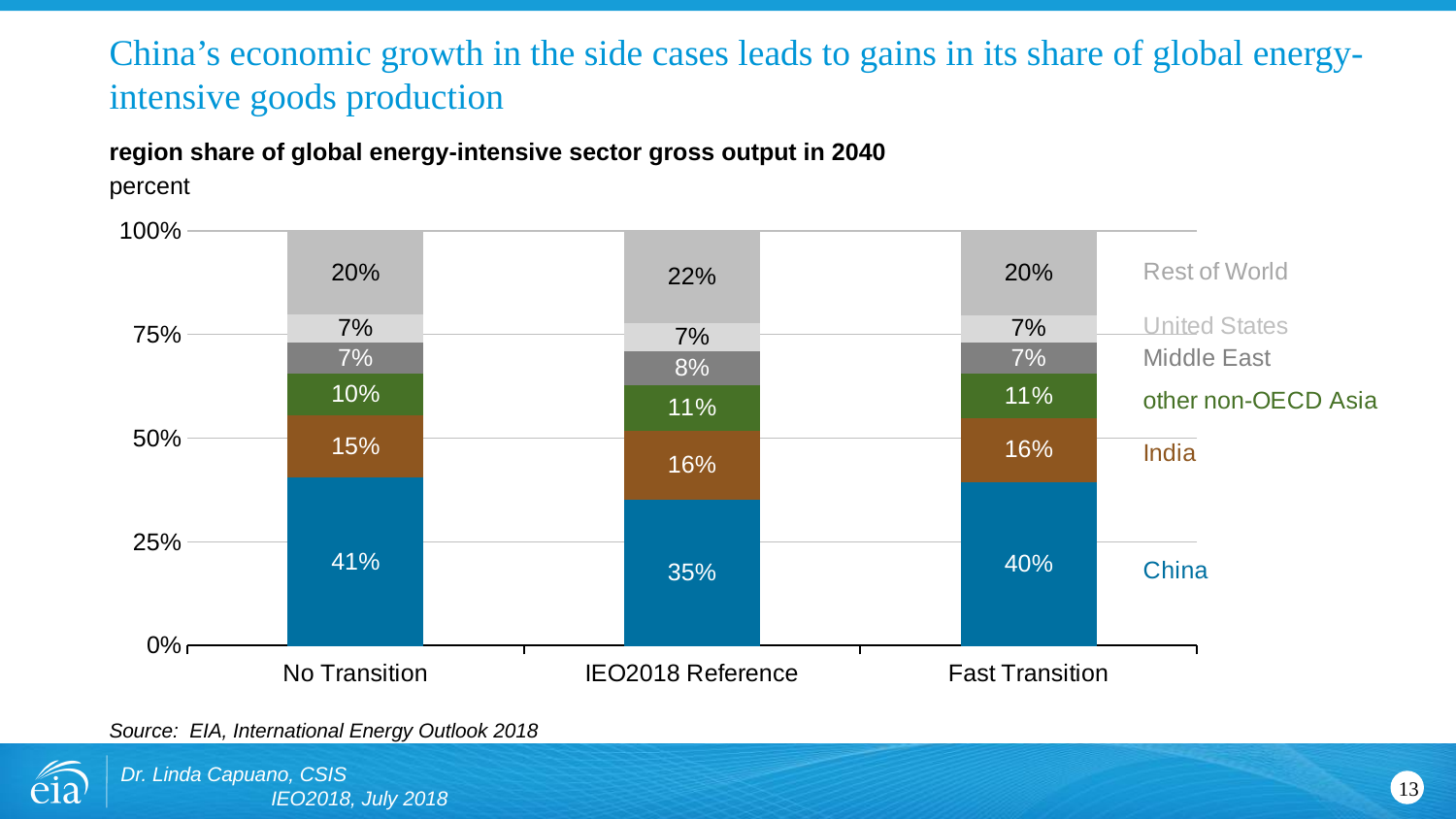
What kind of chart is shown on the slide? Stacked bar chart What is the Middle East share in the Fast Transition case? 7% What is the share for other non-OECD Asia in the No Transition case? 10% In which case is China's share the lowest? IEO2018 Reference How many percentage points higher is China's share in the No Transition case than in the IEO2018 Reference case? 6 percentage points What is the Rest of World share in the IEO2018 Reference case? 22% How many regions does the legend list? 6 In which case is China's share the highest? No Transition Which is larger in the Fast Transition case: China's share or India's share? China What is India's share in the IEO2018 Reference case? 16% What is China's share of global energy-intensive sector gross output in 2040 in the No Transition case? 41% How many cases (bars) are shown on the x axis? 3